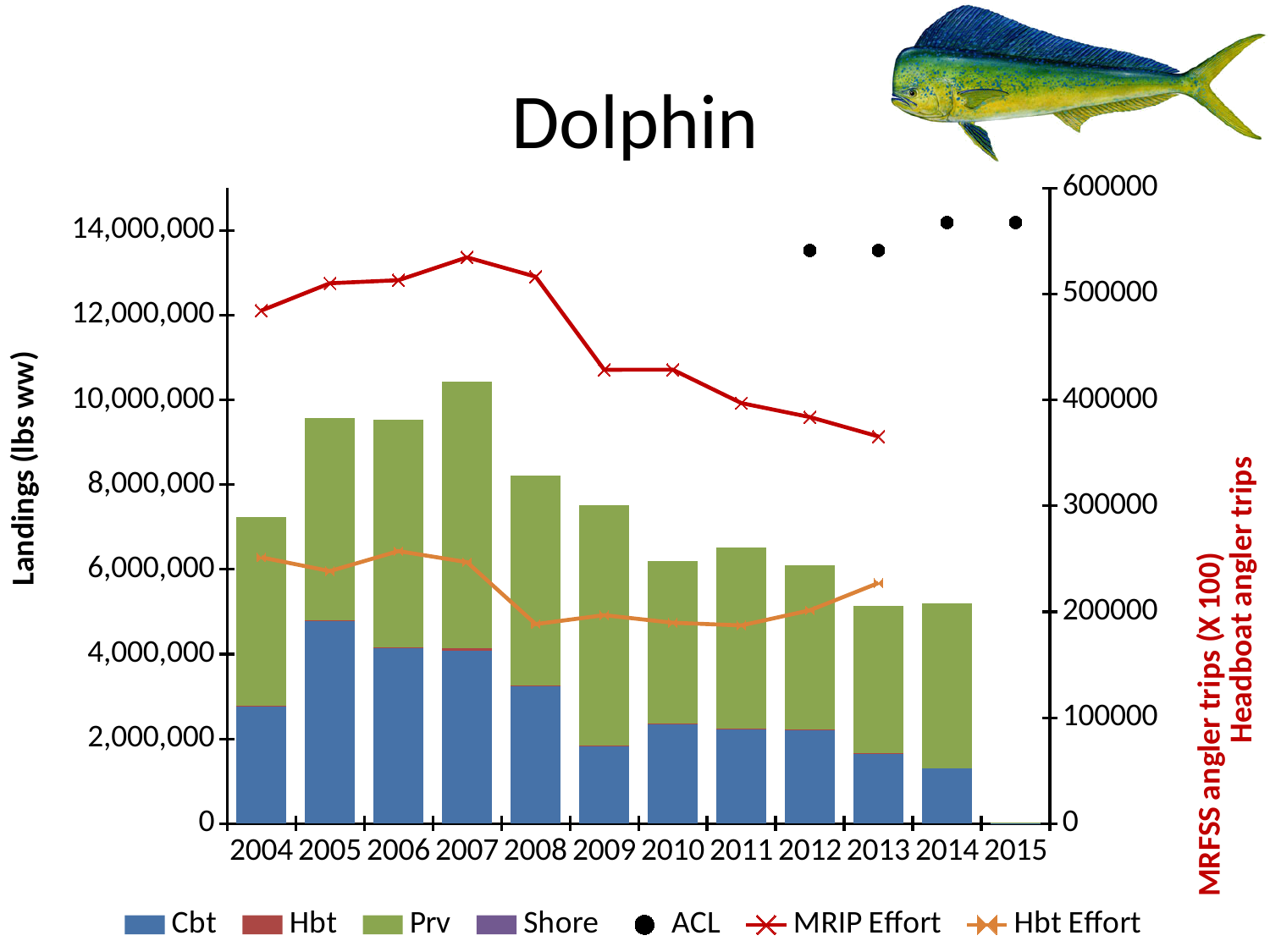
Which year has the highest MRIP Effort value? 2007 Is the total landings bar for 2004 greater or less than 8,000,000? less How many years are shown on the x axis? 12 Is the total landings bar for 2007 greater or less than 10,000,000? greater Is the MRIP Effort value for 2013 greater or less than 400000? less Which year has the tallest stacked landings bar? 2007 How many series does the legend list? 7 Does the MRIP Effort line rise or fall from 2008 to 2013? fall What is the title of the chart? Dolphin Which year has the lowest total landings? 2015 What kind of chart is used for the landings data? Stacked bar chart Which is larger, the Cbt landings in 2005 or in 2009? 2005